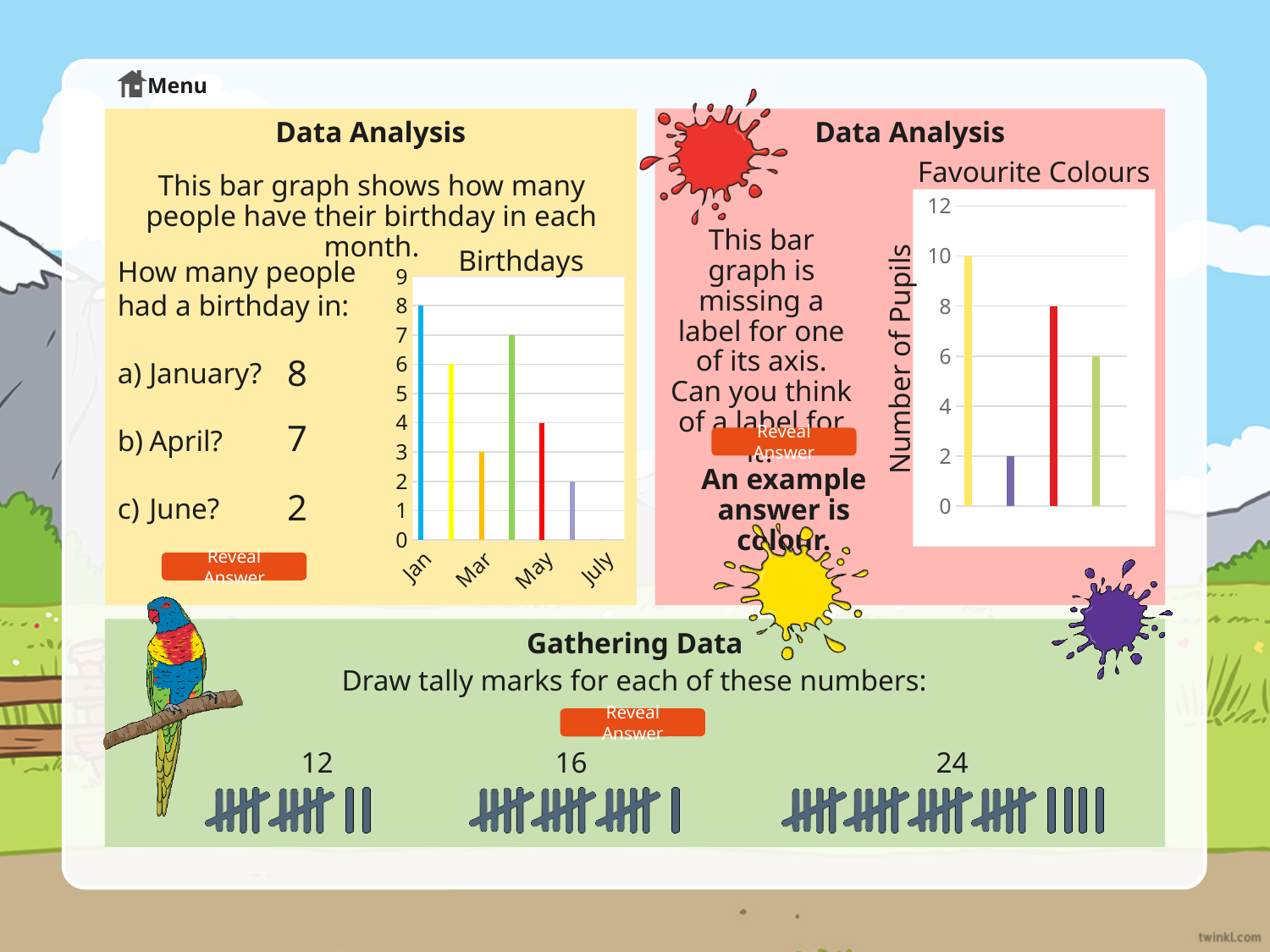
In the Birthdays chart, how many people had a birthday in April? 7 In the Birthdays chart, what is the difference between the January and June values? 6 In the Favourite Colours chart, which coloured bar is the lowest? purple In the Birthdays chart, how many people had a birthday in June? 2 In the Birthdays chart, what is the value of the bar for Mar? 3 In the Birthdays chart, which month has the tallest bar? Jan In the Birthdays chart, how many people had a birthday in January? 8 In the Favourite Colours chart, what is the label on the vertical axis? Number of Pupils In the Birthdays chart, is the value for May greater or less than 5? less In the Favourite Colours chart, what is the value of the yellow bar? 10 In the Favourite Colours chart, how many bars are plotted? 4 What kind of chart is the Birthdays chart? bar chart